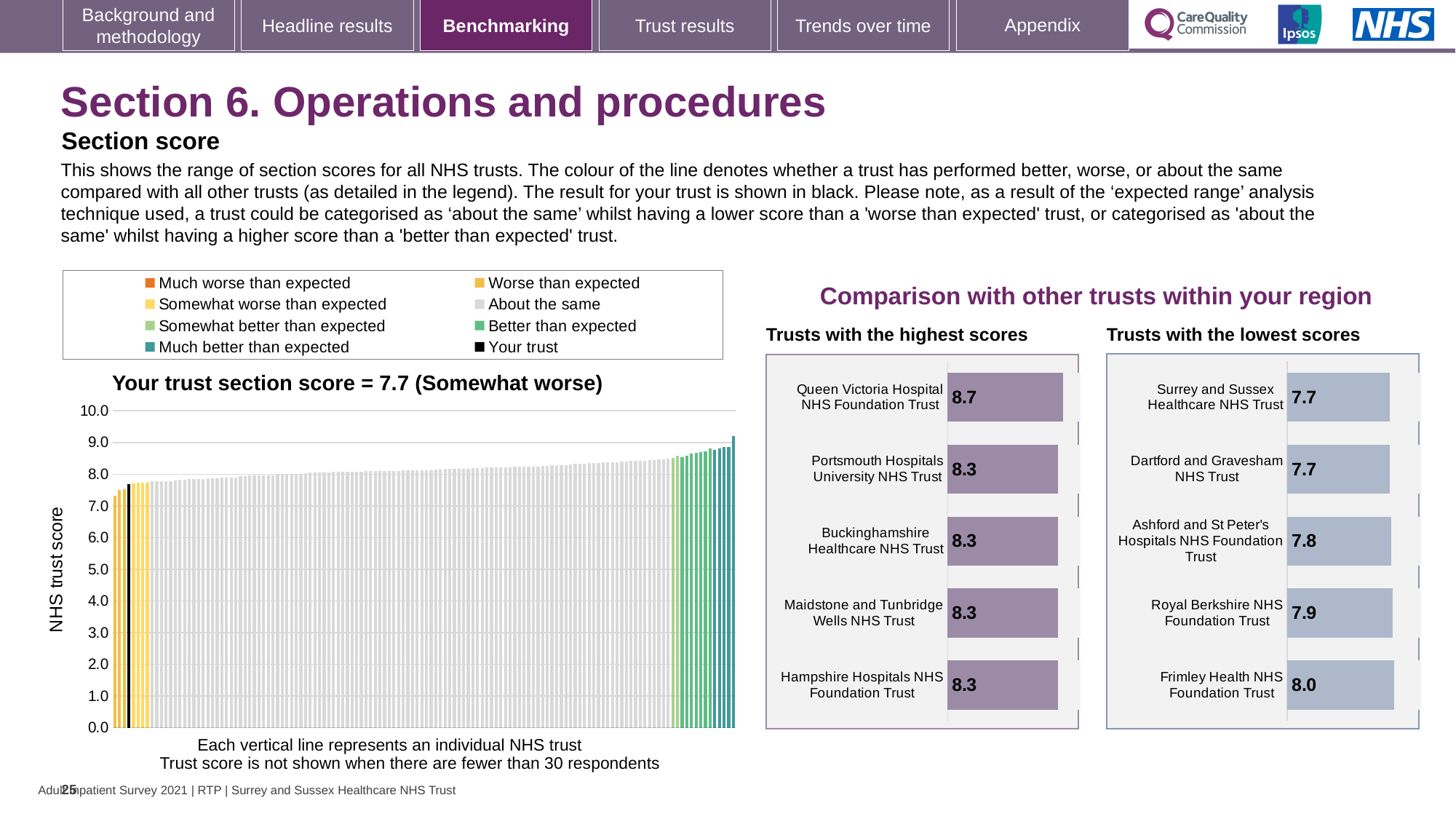
In the 'Your trust section score' chart, do the trust scores rise or fall from left to right along the x axis? rise In the 'Trusts with the highest scores' chart, what is the difference between the scores of Queen Victoria Hospital NHS Foundation Trust and Portsmouth Hospitals University NHS Trust? 0.4 What kind of chart is the 'Your trust section score' chart? bar chart In the 'Trusts with the lowest scores' chart, what is the score for Frimley Health NHS Foundation Trust? 8.0 In the 'Trusts with the highest scores' chart, what is the score for Queen Victoria Hospital NHS Foundation Trust? 8.7 In the 'Your trust section score' chart, what is the section score for your trust? 7.7 In the 'Trusts with the lowest scores' chart, which has the larger score: Ashford and St Peter's Hospitals NHS Foundation Trust or Royal Berkshire NHS Foundation Trust? Royal Berkshire NHS Foundation Trust In the 'Trusts with the lowest scores' chart, what is the score for Royal Berkshire NHS Foundation Trust? 7.9 In the 'Trusts with the lowest scores' chart, what is the difference between the scores of Frimley Health NHS Foundation Trust and Surrey and Sussex Healthcare NHS Trust? 0.3 How many trusts are shown in the 'Trusts with the highest scores' chart? 5 In the 'Trusts with the lowest scores' chart, which trust has the highest score? Frimley Health NHS Foundation Trust In the 'Trusts with the highest scores' chart, which trust has the highest score? Queen Victoria Hospital NHS Foundation Trust